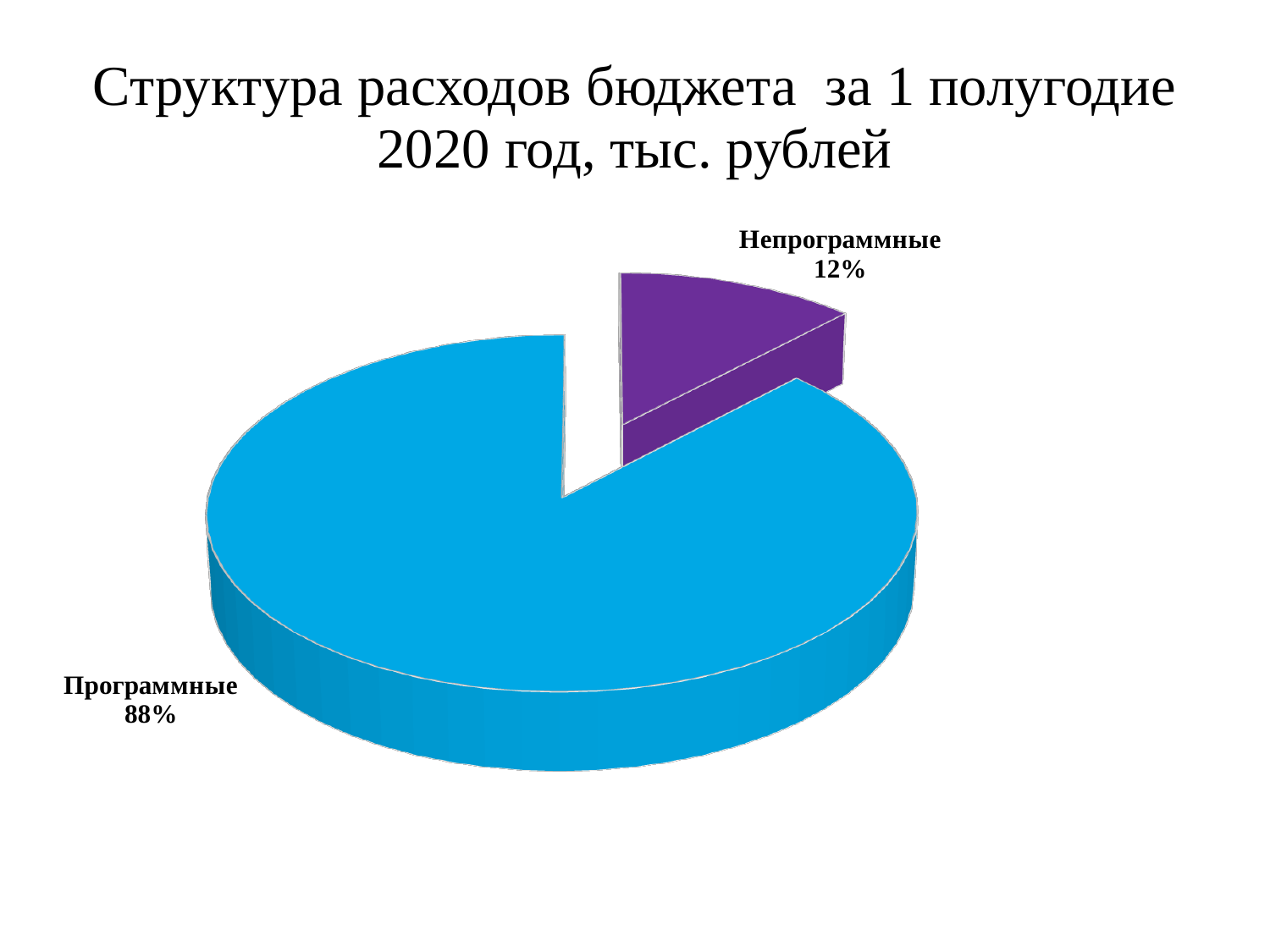
How many slices does the pie chart have? 2 What is the difference in percentage points between the Программные and Непрограммные slices? 76 What share of the pie does the Непрограммные slice represent? 12% Which is larger, the Программные slice or the Непрограммные slice? Программные What kind of chart is shown on the slide? Pie chart What is the title of the slide? Структура расходов бюджета за 1 полугодие 2020 год, тыс. рублей What share of the pie does the Программные slice represent? 88% What colour is the Непрограммные slice? Purple Which category has the smallest slice of the pie? Непрограммные Which category has the largest slice of the pie? Программные